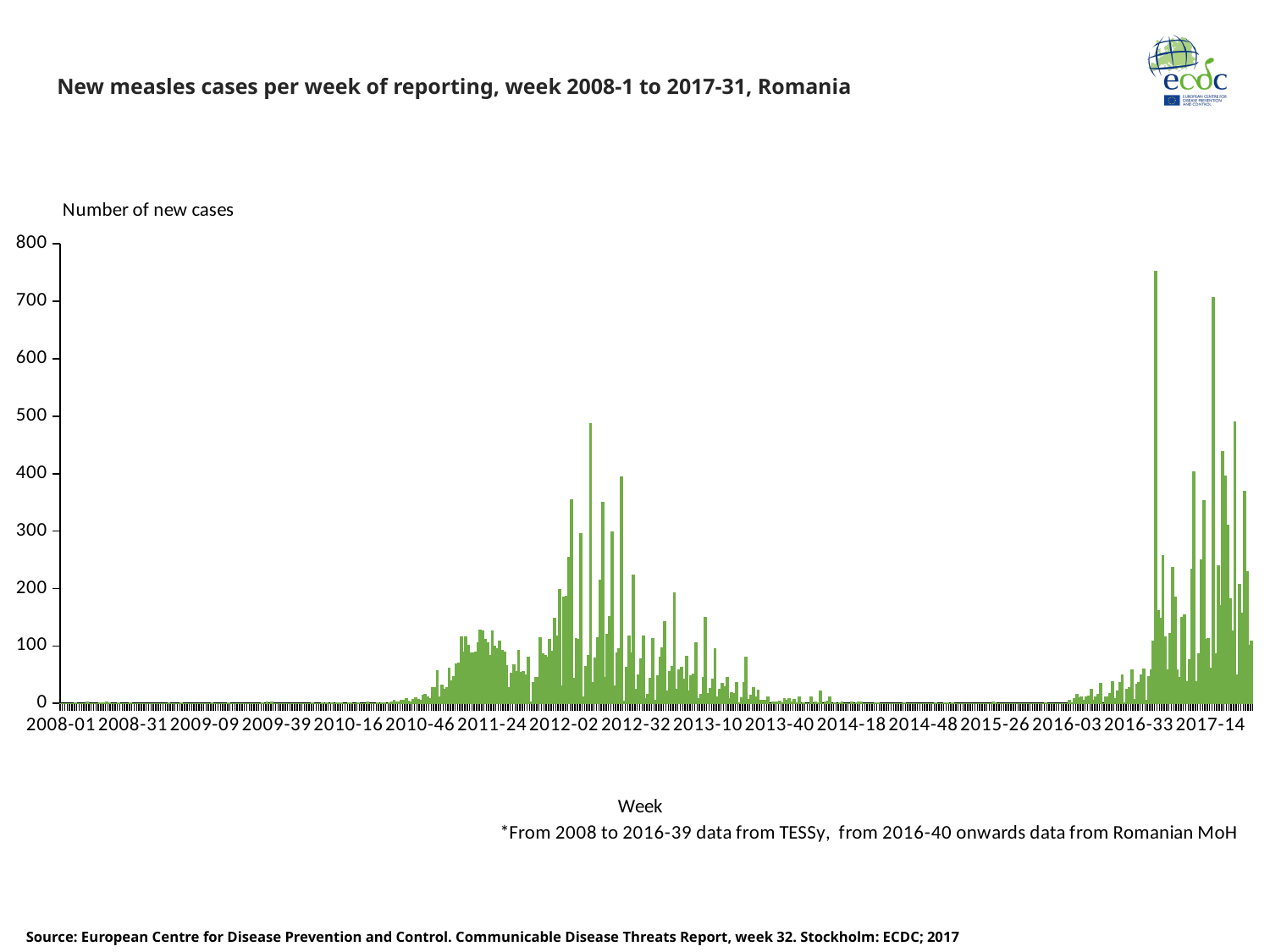
What is the label of the vertical axis? Number of new cases Is the highest weekly value on the chart greater or less than 700? greater Is the value for week 2008-01 greater or less than 100? less Is the value for week 2014-48 greater or less than 100? less What kind of chart is shown on the slide? Bar chart Which period has the taller peak: around 2012-02 or around 2016-33 to 2017-14? Around 2016-33 to 2017-14 What is the title of the chart? New measles cases per week of reporting, week 2008-1 to 2017-31, Romania